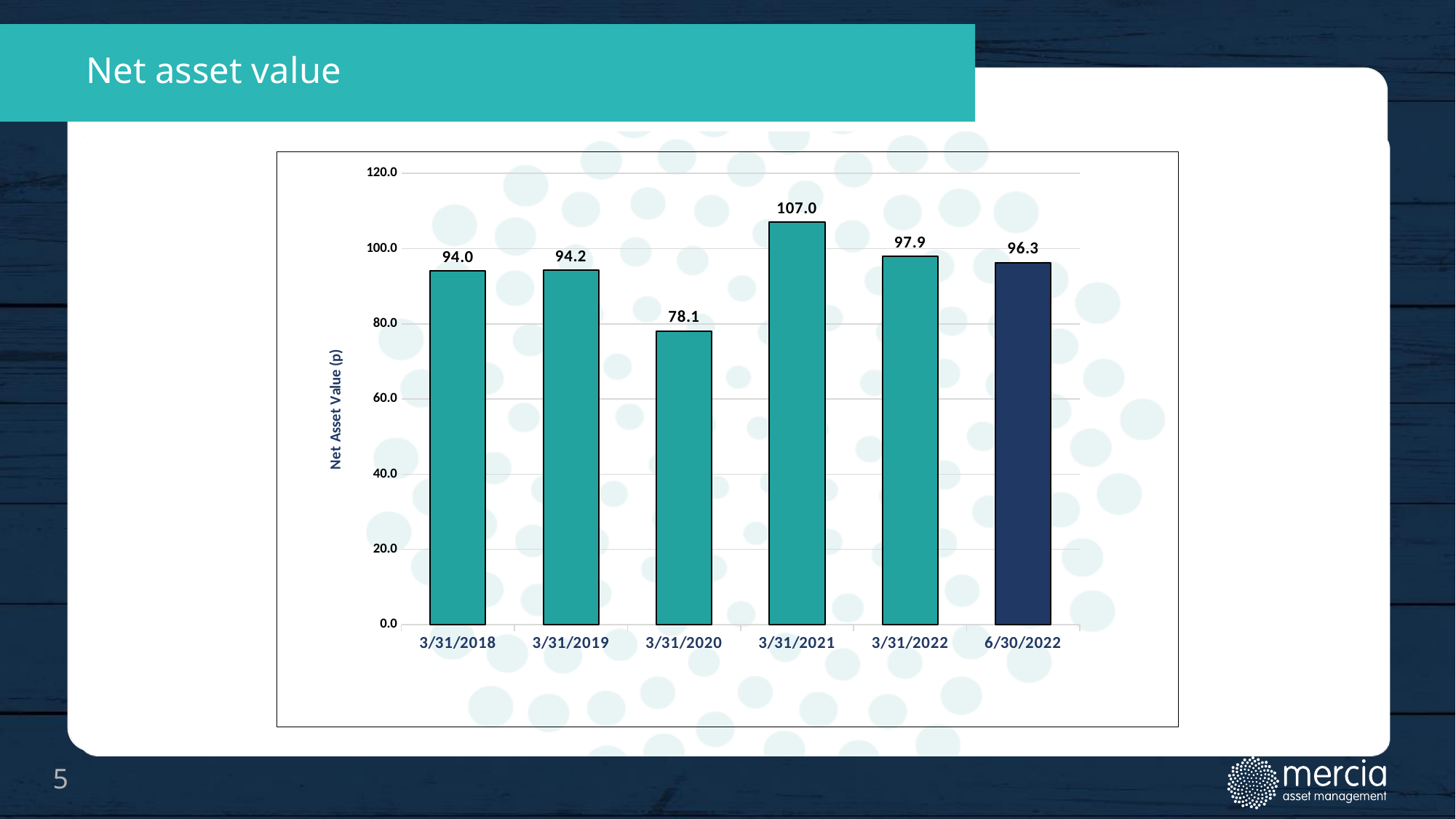
What is the label of the vertical axis of the chart? Net Asset Value (p) Which is larger, the net asset value on 3/31/2019 or on 6/30/2022? 6/30/2022 What is the difference between the net asset value on 3/31/2022 and on 6/30/2022? 1.6 What is the difference between the net asset value on 3/31/2021 and on 3/31/2020? 28.9 Is the net asset value for 3/31/2021 greater or less than 100.0? greater Which date has the lowest net asset value? 3/31/2020 What kind of chart is shown on the slide? bar chart What is the net asset value for 3/31/2020? 78.1 What is the net asset value for 3/31/2018? 94.0 What is the net asset value for 6/30/2022? 96.3 How many dates are shown on the x axis of the chart? 6 Which date has the highest net asset value? 3/31/2021